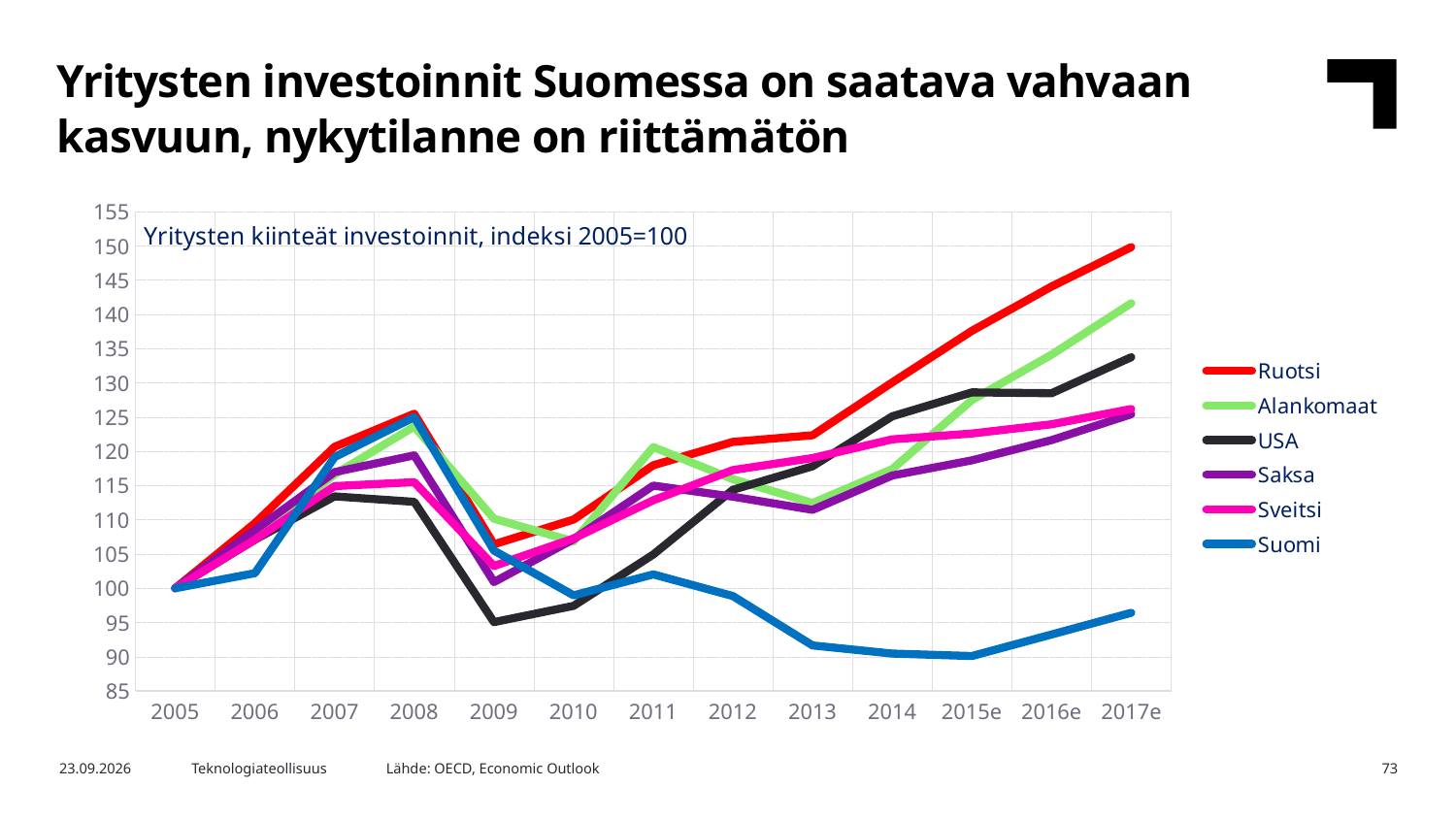
Which country has the lowest index value in 2009? USA Is the value for Suomi in 2015e greater or less than 95? less What is the index value for Suomi in 2005? 100 Which country has the lowest index value in 2017e? Suomi How many years are shown along the x axis? 13 Is the value for Ruotsi in 2017e greater or less than 140? greater Does the Suomi line rise or fall from 2012 to 2015e? fall What is the subtitle printed inside the chart area? Yritysten kiinteät investoinnit, indeksi 2005=100 Which country has the highest index value in 2017e? Ruotsi What type of chart is shown on the slide? line chart In 2017e, which is higher: Alankomaat or USA? Alankomaat How many series does the legend list? 6